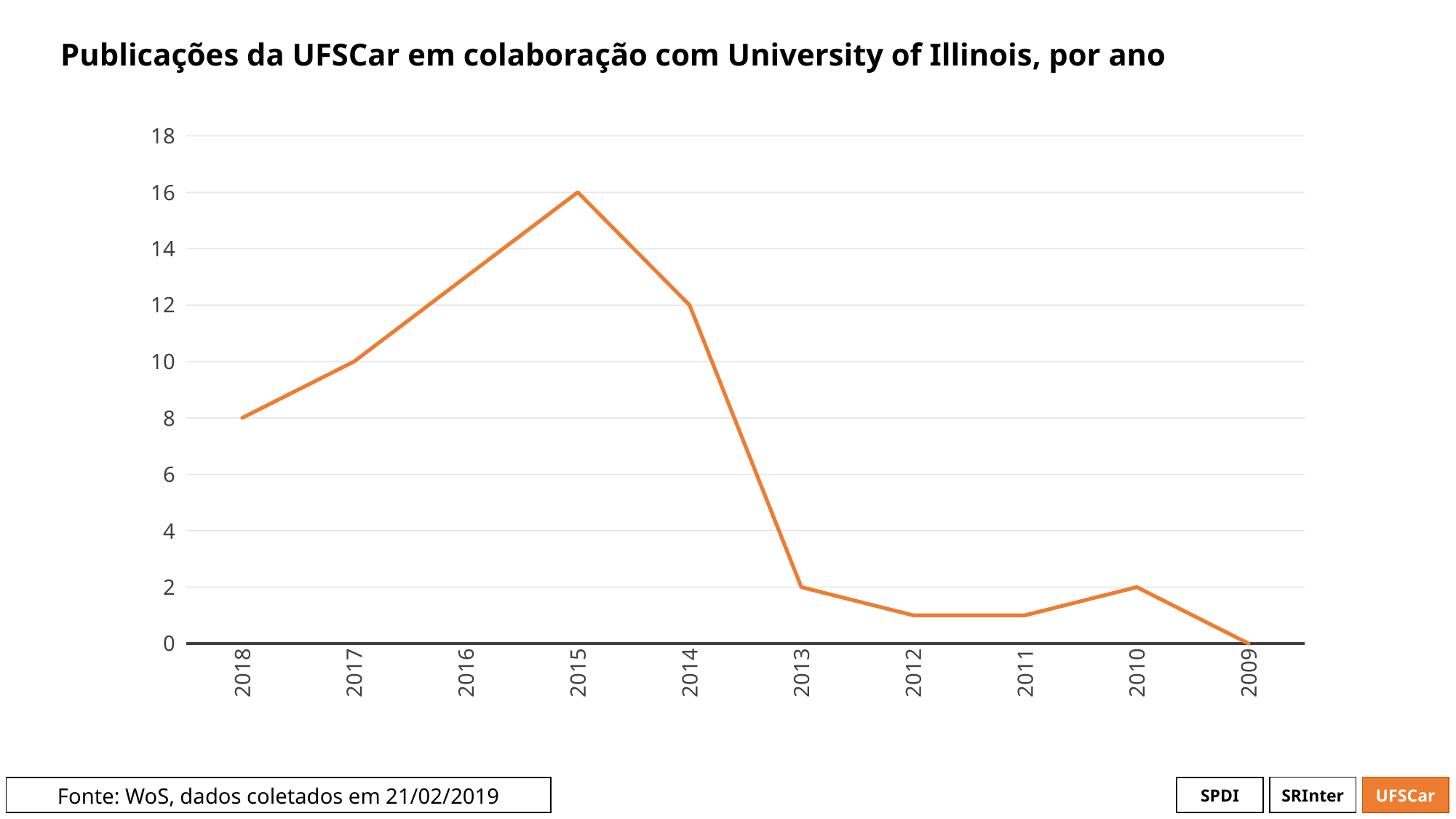
Which year has the highest value? 2015 What is the difference between the values for 2015 and 2014? 4 What is the value for 2014? 12 Which year has the lowest value? 2009 How many years are plotted on the x axis? 10 What kind of chart is shown on the slide? line chart What is the value for 2009? 0 Does the value rise or fall from 2014 to 2013? fall What is the value for 2018? 8 What is the value for 2015? 16 Is the value for 2016 greater or less than 12? greater Which year has the larger value, 2017 or 2018? 2017